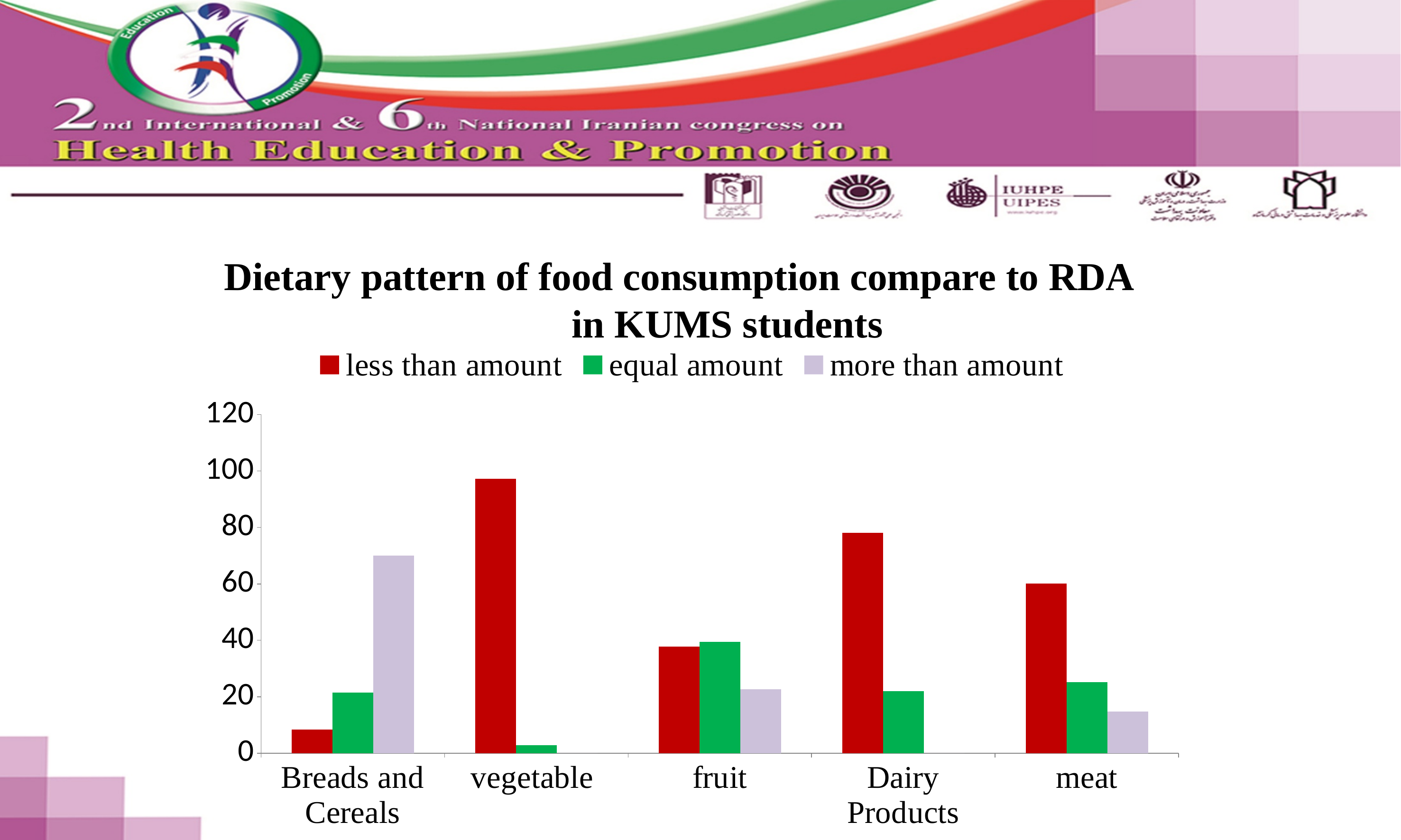
What colour represents the "equal amount" series in the legend? green Is the "equal amount" value for vegetable greater or less than 20? less How many food categories are shown on the x axis? 5 What kind of chart is shown on the slide? bar chart How many series does the legend list? 3 Which food category has the highest value for "more than amount"? Breads and Cereals Is the "more than amount" value for Breads and Cereals greater or less than 60? greater Which is larger for Breads and Cereals: "more than amount" or "less than amount"? more than amount Which food category has the lowest value for "less than amount"? Breads and Cereals Which is larger for Dairy Products: "less than amount" or "equal amount"? less than amount Is the "less than amount" value for vegetable greater or less than 80? greater Which food category has the highest value for "less than amount"? vegetable